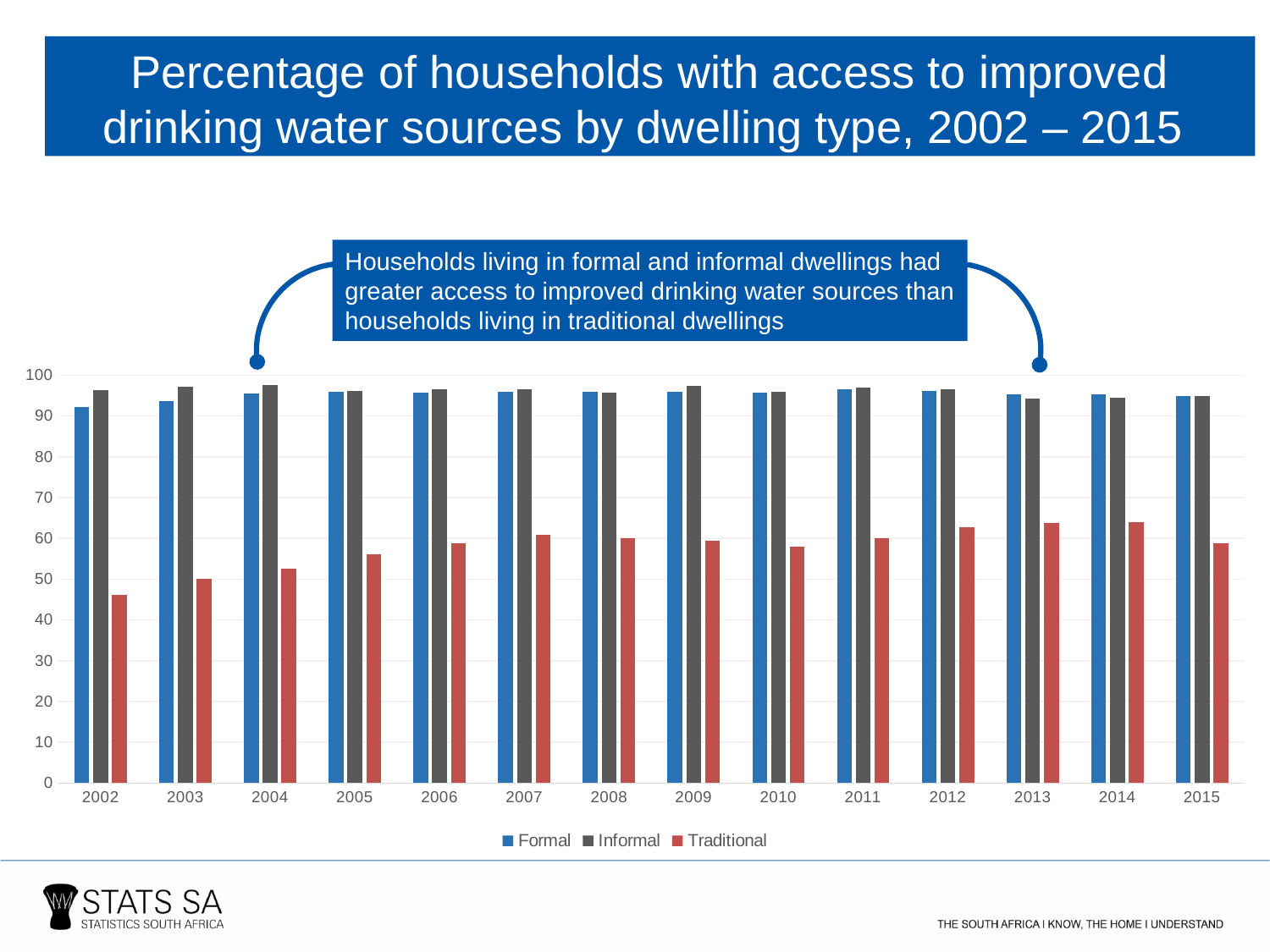
What colour are the bars for the Traditional series? red Is the value for Traditional in 2013 greater or less than 60? greater How many years are shown along the x axis? 14 How many series does the legend list? 3 What kind of chart is shown on the slide? bar chart Which year has the lowest value for the Traditional series? 2002 Is the value for Formal in 2002 greater or less than 90? greater Is the value for Traditional in 2005 greater or less than 50? greater Do the Traditional values rise or fall from 2002 to 2007? rise For the Traditional series, which is larger: the value in 2002 or the value in 2014? 2014 In 2010, which is larger: the Formal value or the Traditional value? Formal